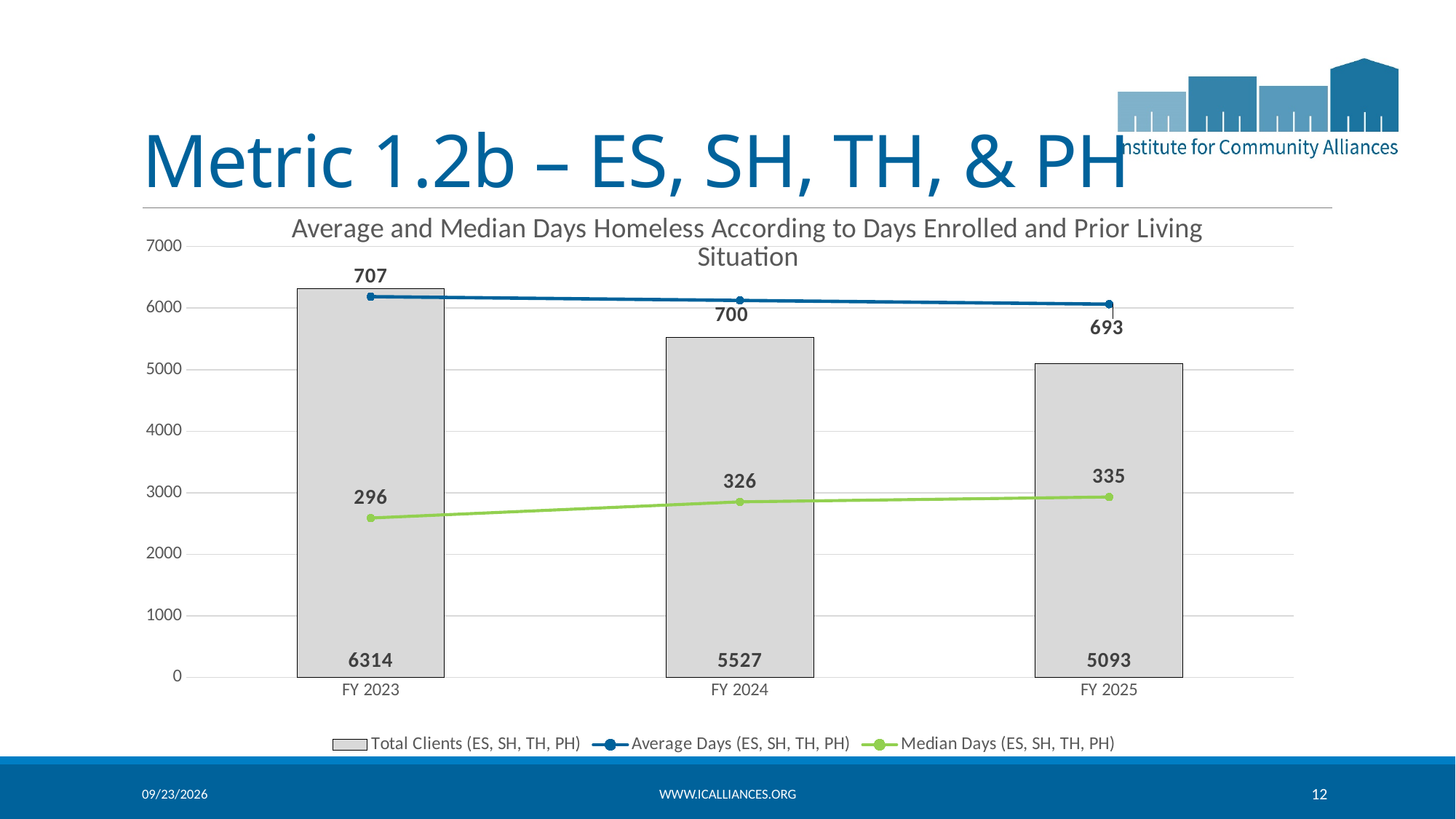
What is the value of Average Days (ES, SH, TH, PH) for FY 2025? 693 Is the Total Clients (ES, SH, TH, PH) bar for FY 2024 greater or less than 5000? greater What is the difference in Average Days (ES, SH, TH, PH) between FY 2023 and FY 2024? 7 How many series does the legend list? 3 Which fiscal year has the lowest Median Days (ES, SH, TH, PH)? FY 2023 What is the value of Median Days (ES, SH, TH, PH) for FY 2024? 326 What is the difference in Total Clients (ES, SH, TH, PH) between FY 2023 and FY 2025? 1221 What is the value of Total Clients (ES, SH, TH, PH) for FY 2023? 6314 How many fiscal years are shown on the x axis? 3 Which is larger: Median Days (ES, SH, TH, PH) in FY 2025 or in FY 2023? FY 2025 Do the Total Clients (ES, SH, TH, PH) values rise or fall from FY 2023 to FY 2025? fall Which fiscal year has the highest Total Clients (ES, SH, TH, PH)? FY 2023